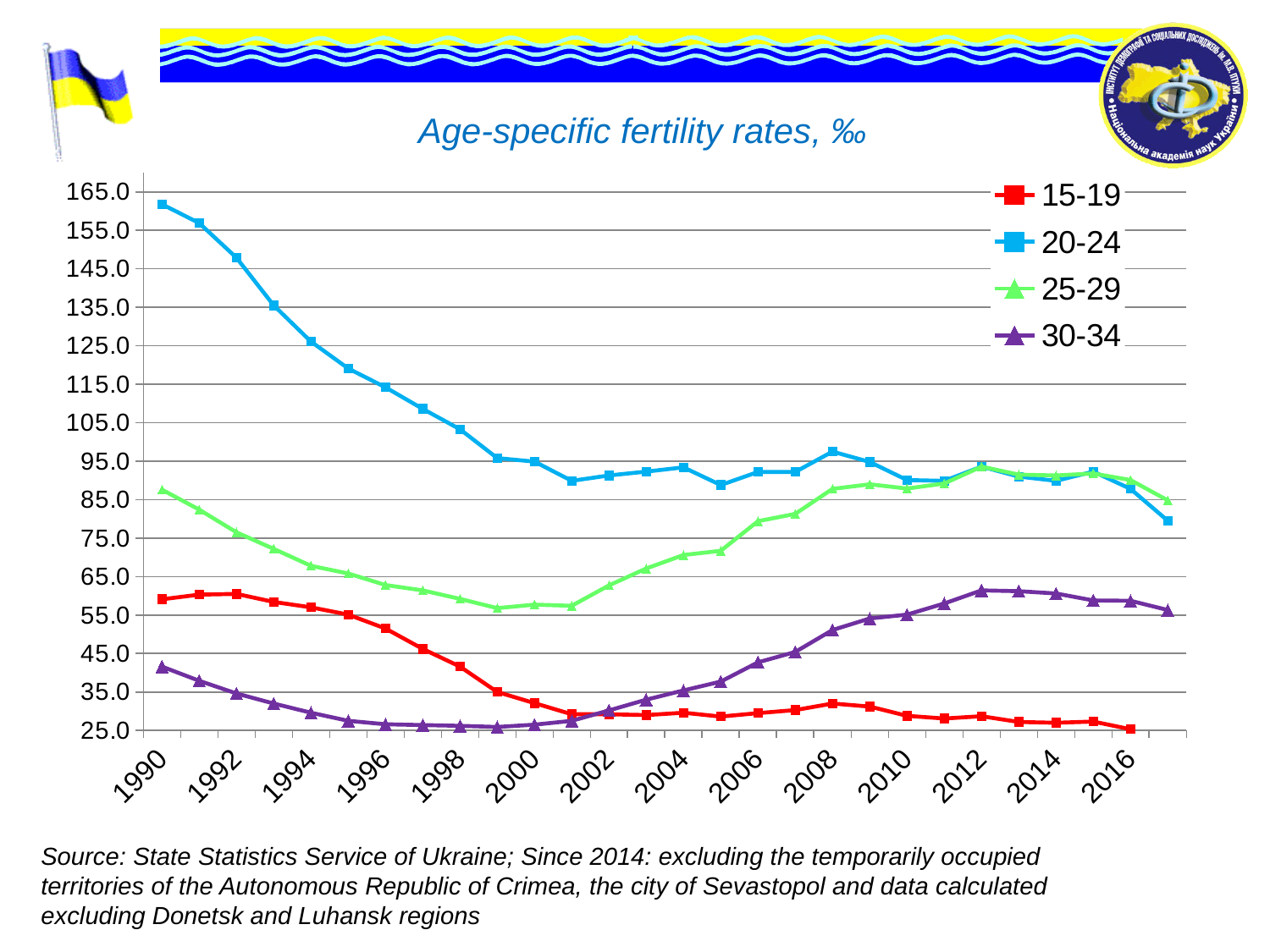
Which age group has the lowest fertility rate in 2016? 15-19 What is the title of the chart? Age-specific fertility rates, ‰ Is the value for the 20-24 age group in 1990 greater or less than 155? greater Is the value for the 30-34 age group in 2012 greater or less than 55? greater Which age group has the highest fertility rate in 1990? 20-24 Does the fertility rate for the 20-24 age group rise or fall between 1990 and 2000? fall How many series does the legend list? 4 What kind of chart is shown on the slide? line chart Does the fertility rate for the 30-34 age group rise or fall between 2000 and 2012? rise Is the value for the 15-19 age group in 2016 greater or less than 35? less Which age group has the lowest fertility rate in 1990? 30-34 In 2016, which age group has the larger fertility rate, 25-29 or 30-34? 25-29